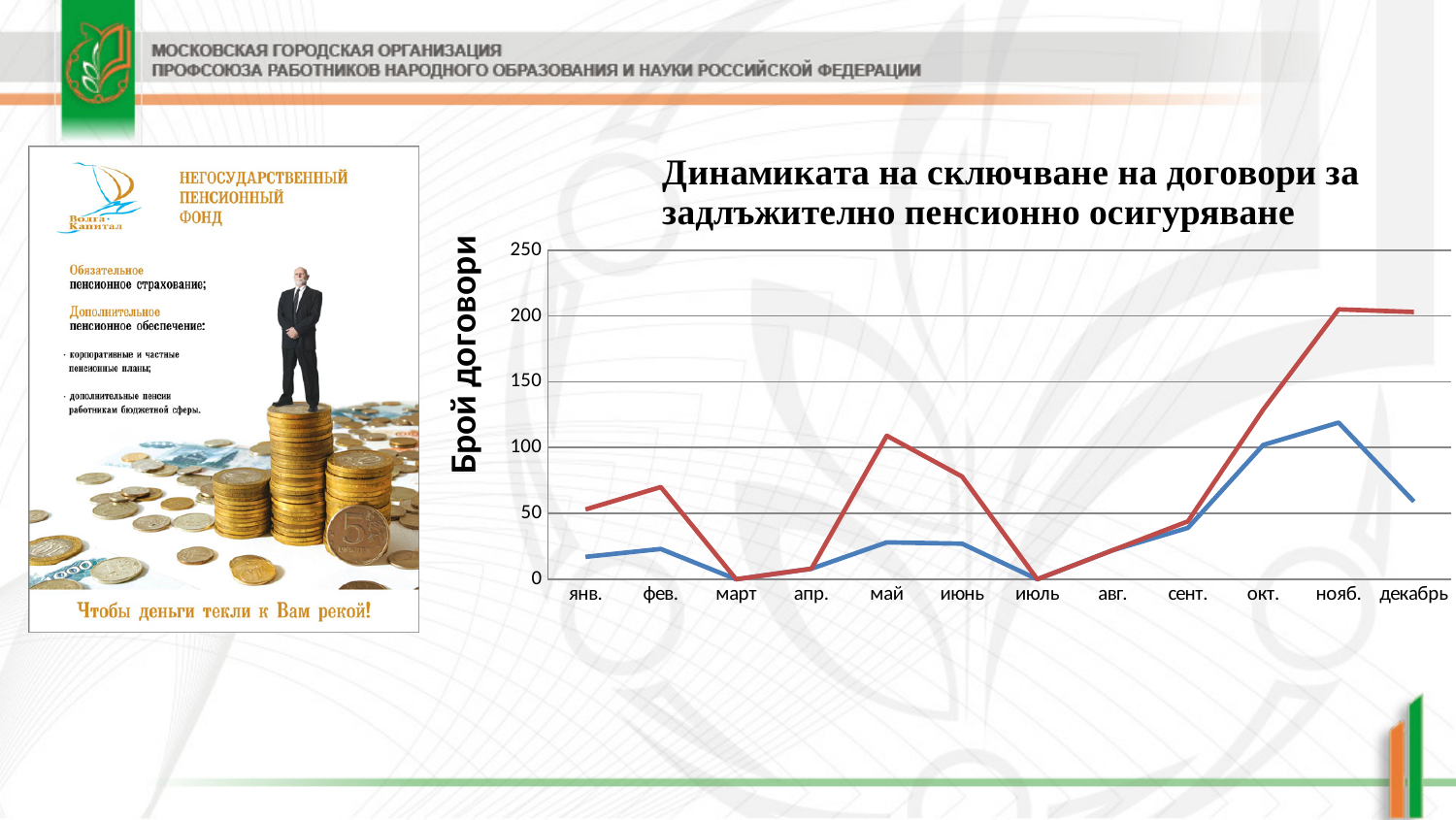
How many lines are plotted on the chart? 2 Is the value of the blue line for май greater or less than 50? less Does the red line rise or fall from сент. to нояб.? rise In which month does the blue line reach its highest value? нояб. Is the value of the red line for нояб. greater or less than 150? greater What kind of chart is shown on the slide? line chart Is the value of the blue line for декабрь greater or less than 100? less In май, which line has the larger value, the red line or the blue line? the red line How many months are shown along the x axis of the chart? 12 What is the label on the vertical axis of the chart? Брой договори What is the title of the chart? Динамиката на сключване на договори за задлъжително пенсионно осигуряване